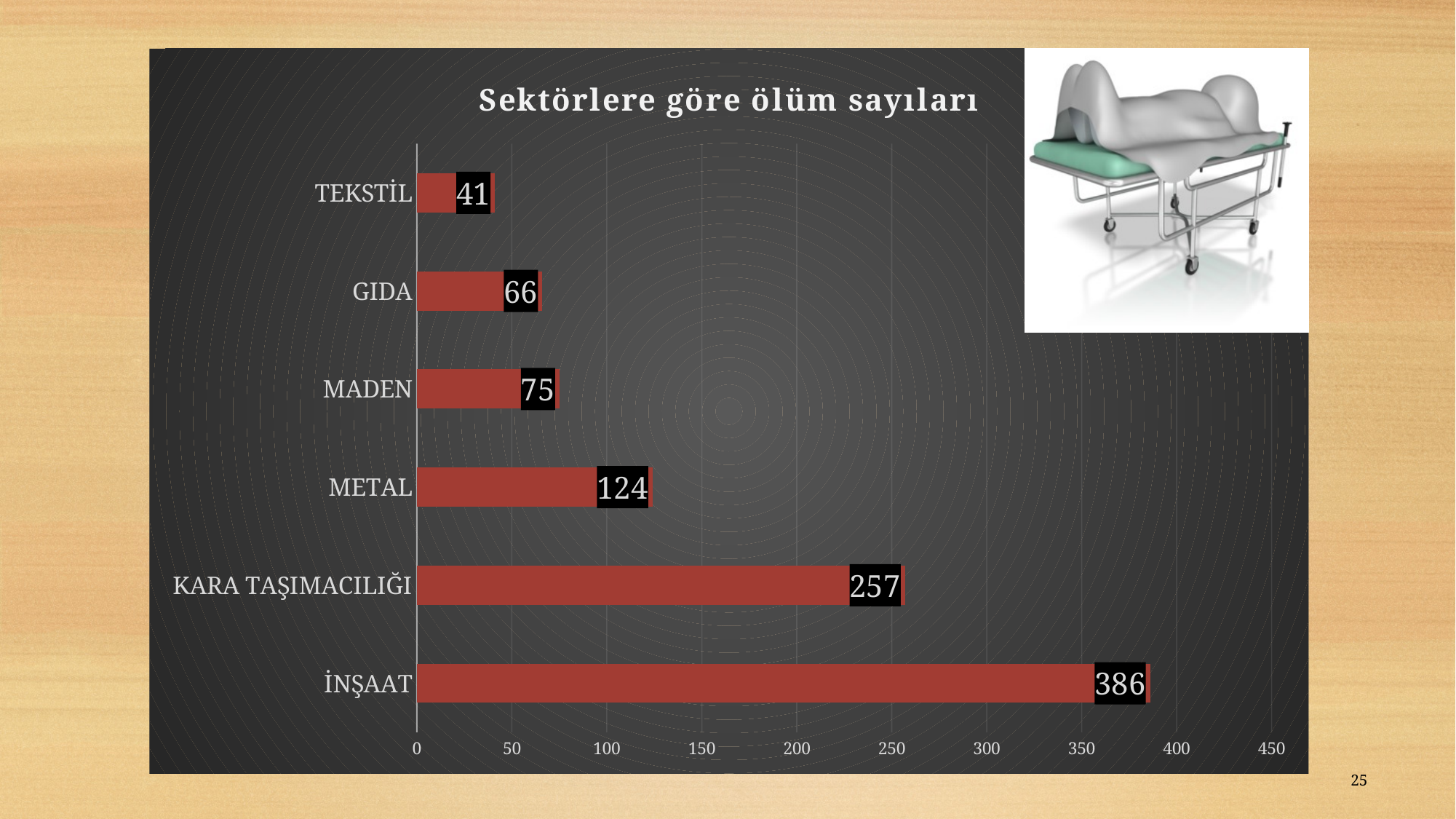
What is the value for KARA TAŞIMACILIĞI? 257 What is the value for İNŞAAT? 386 What is the value for TEKSTİL? 41 What is the difference between the values for İNŞAAT and KARA TAŞIMACILIĞI? 129 What is the value for METAL? 124 Which is larger, the value for MADEN or the value for GIDA? MADEN What is the title of the chart? Sektörlere göre ölüm sayıları Which sector has the highest number of deaths? İNŞAAT What kind of chart is shown on the slide? bar chart Which sector has the lowest number of deaths? TEKSTİL What is the difference between the values for MADEN and GIDA? 9 How many sectors are shown in the chart? 6